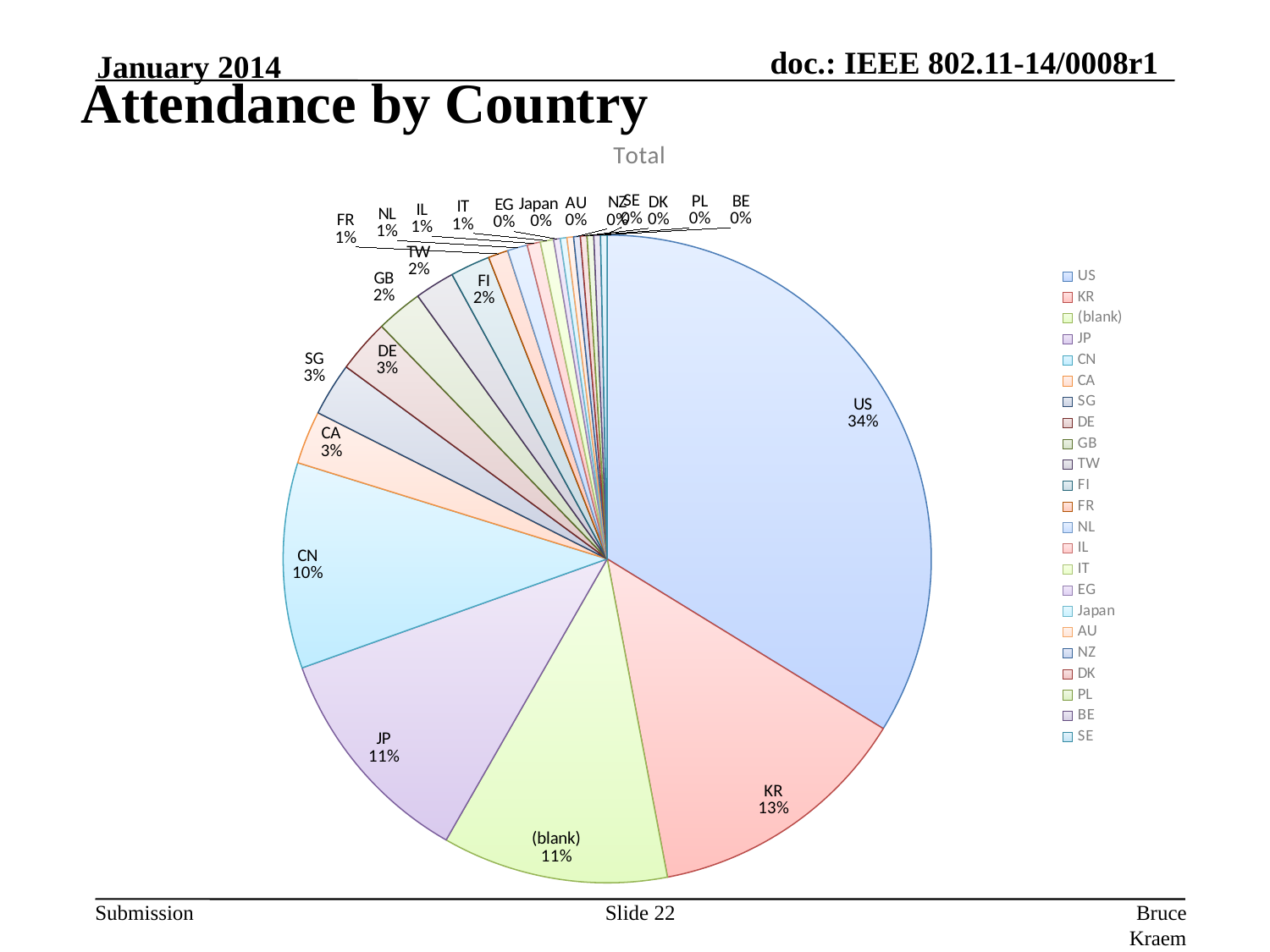
What is the chart's title? Total What is the value shown for JP? 11% What is the difference in percentage points between the US slice and the KR slice? 21 What is the value shown for GB? 2% What is the value shown for KR? 13% What is the value shown for DE? 3% Which country has the largest slice of the pie? US How many entries does the legend list? 23 What is the value shown for CN? 10% Which is larger, the slice for KR or the slice for CN? KR What share of attendance does US account for? 34% What type of chart is shown on the slide? pie chart